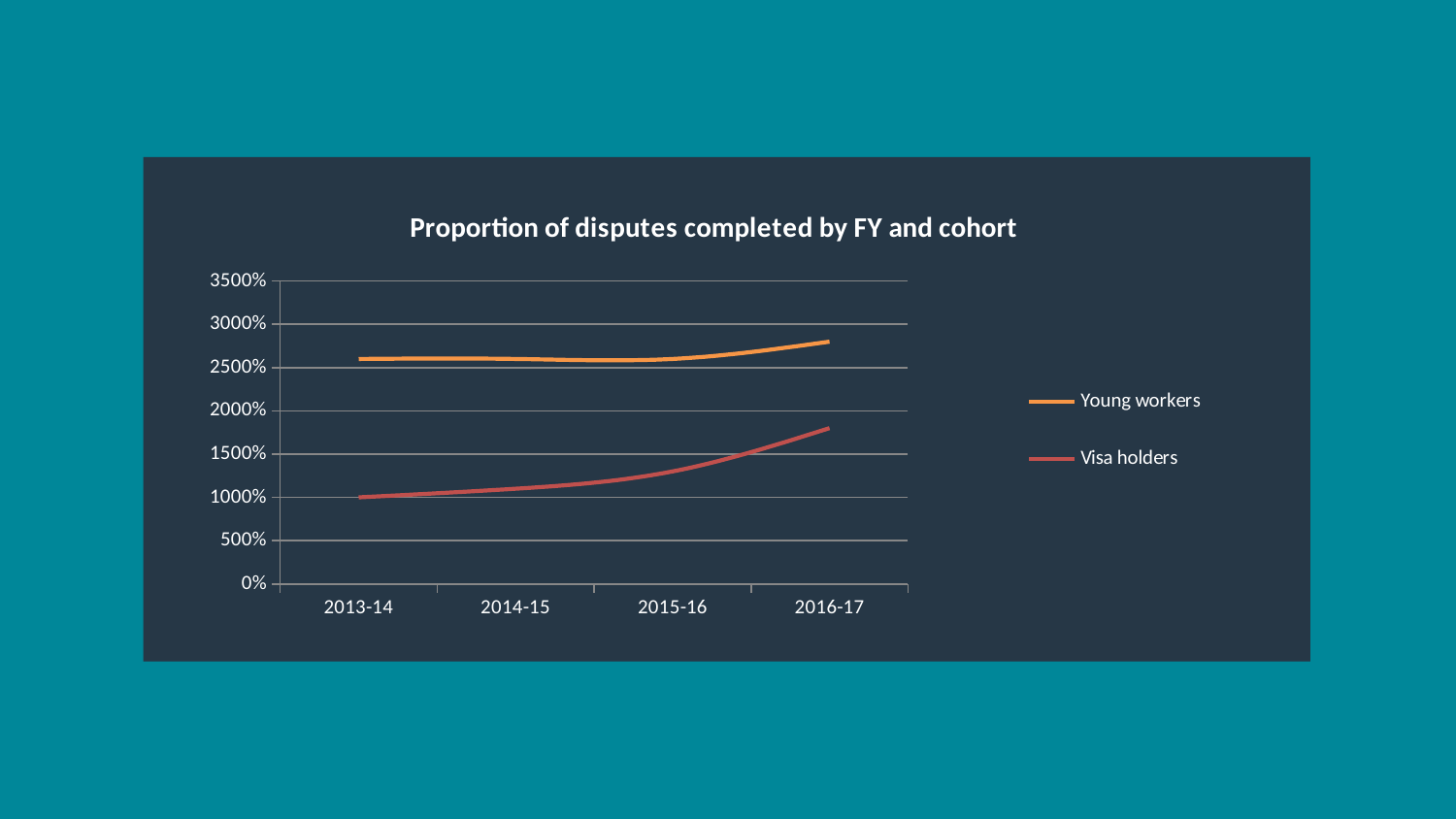
What kind of chart is shown on the slide? line chart In which financial year is the Visa holders value highest? 2016-17 What colour is the line for Young workers? orange What is the title of the chart? Proportion of disputes completed by FY and cohort Is the value for Young workers in 2016-17 greater or less than 3000%? less Is the value for Visa holders in 2016-17 greater or less than 1500%? greater Is the value for Young workers in 2013-14 greater or less than 2500%? greater How many series does the legend list? 2 Do the values for Visa holders rise or fall from 2013-14 to 2016-17? rise In 2016-17, which series has the higher value, Young workers or Visa holders? Young workers How many financial years are shown on the x axis? 4